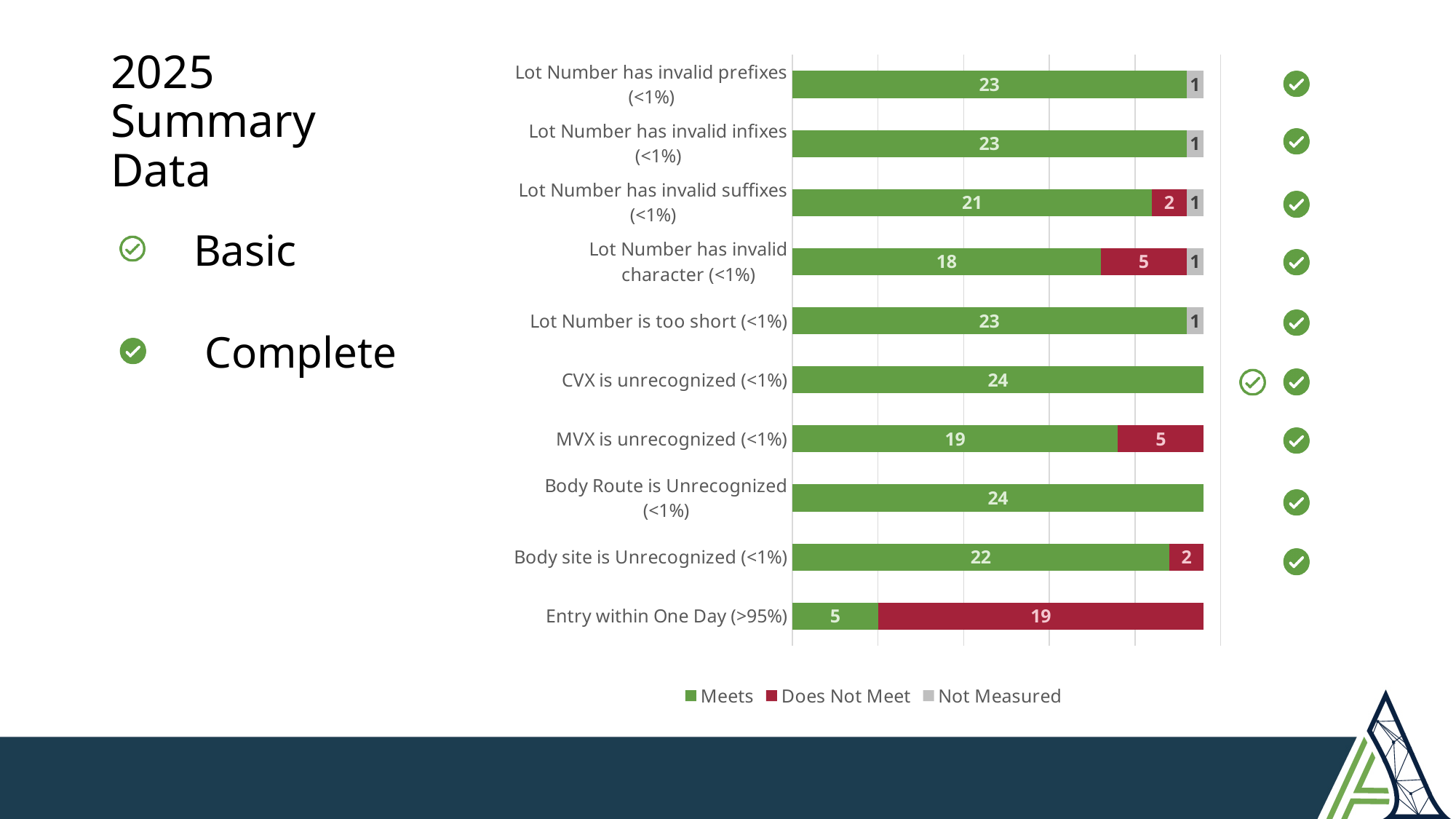
What kind of chart is shown on the slide? Stacked bar chart Which has a larger Meets value: "Lot Number has invalid suffixes (<1%)" or "Body site is Unrecognized (<1%)"? Body site is Unrecognized (<1%) How many series does the legend list? 3 Which category has the highest Does Not Meet value? Entry within One Day (>95%) How many categories are shown in the chart? 10 What is the Does Not Meet value for "MVX is unrecognized (<1%)"? 5 What is the difference between the Meets values for "CVX is unrecognized (<1%)" and "MVX is unrecognized (<1%)"? 5 What is the total of the stacked bar for "Lot Number has invalid suffixes (<1%)"? 24 What is the Does Not Meet value for "Entry within One Day (>95%)"? 19 What is the Meets value for "Lot Number has invalid character (<1%)"? 18 Which category has the lowest Meets value? Entry within One Day (>95%) Which series is shown in red in the legend? Does Not Meet